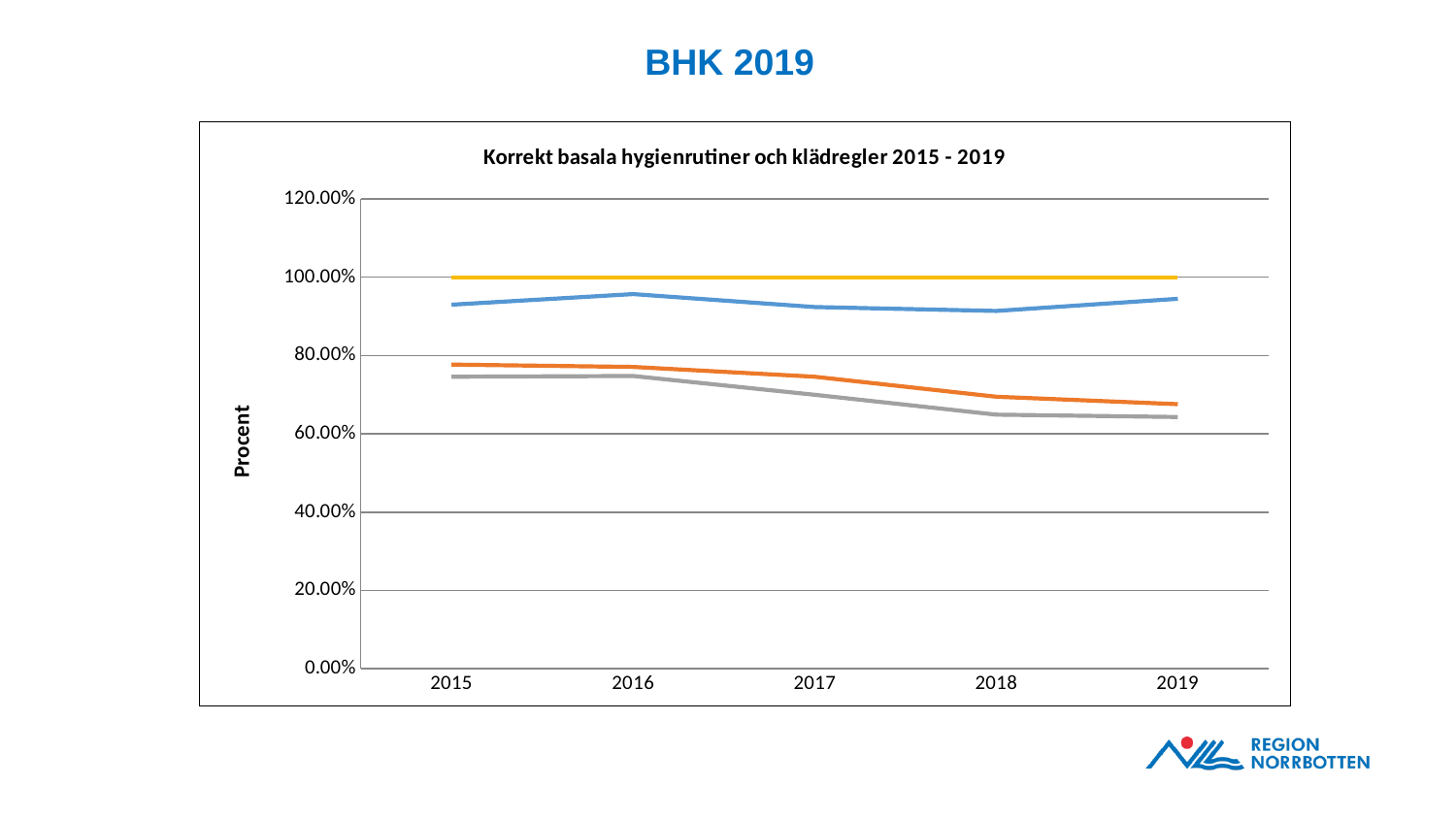
How many years are shown on the x axis of the chart? 5 Which of the four lines has the lowest value in 2019? the grey line What type of chart is shown on the slide? line chart Is the value of the blue line in 2016 greater or less than 80.00%? greater Is the value of the orange line in 2015 greater or less than 60.00%? greater Does the orange line rise or fall from 2015 to 2019? fall Which line is higher in 2018, the blue line or the orange line? the blue line What value does the yellow line sit at across all years? 100.00% What is the label of the y axis? Procent What is the title of the chart? Korrekt basala hygienrutiner och klädregler 2015 - 2019 Does the grey line rise or fall from 2016 to 2019? fall Is the value of the grey line in 2019 greater or less than 80.00%? less